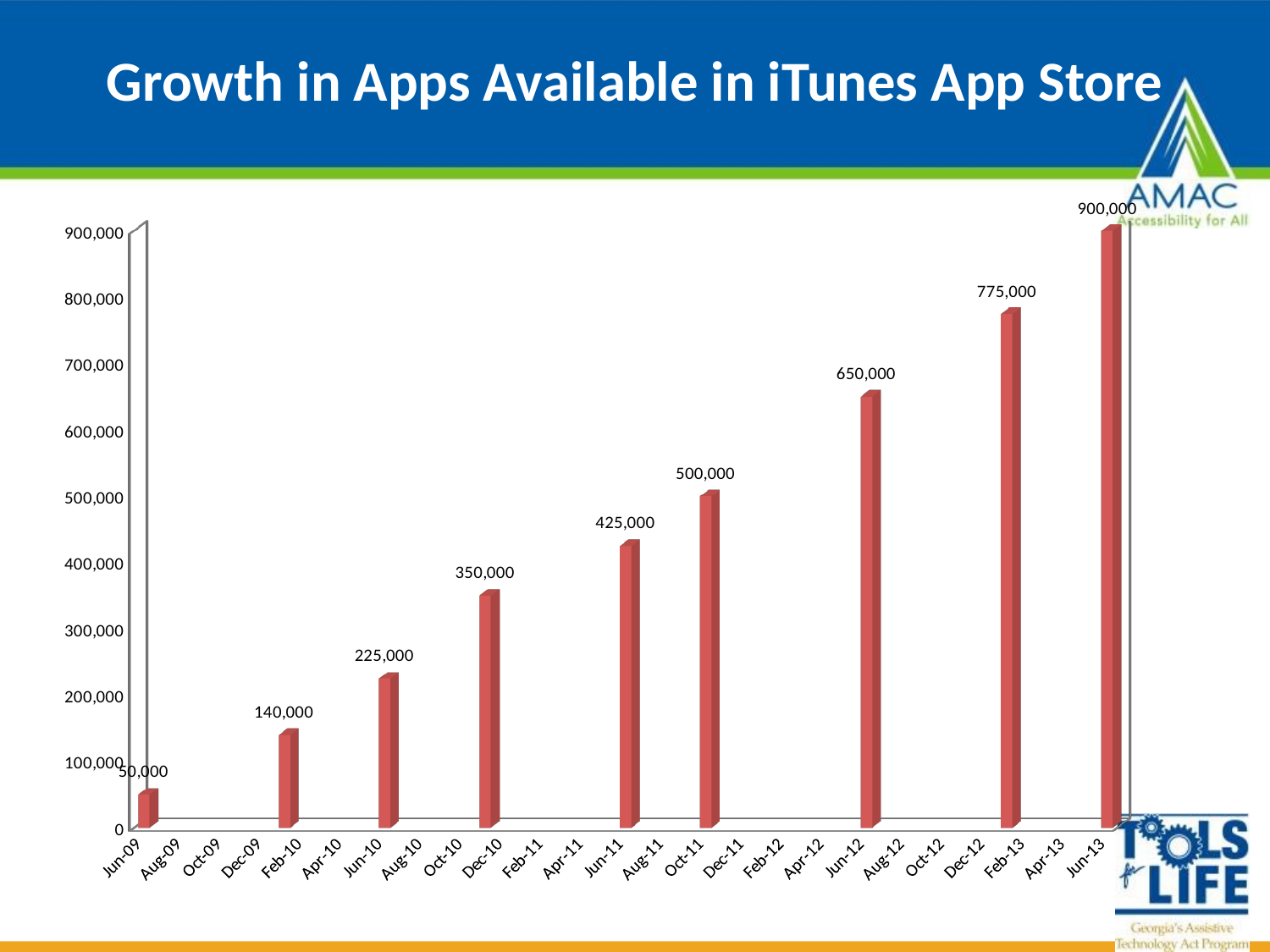
Which date has the lowest number of apps available? Jun-09 What kind of chart is shown on the slide? Bar chart What is the title of the chart? Growth in Apps Available in iTunes App Store Which date has the highest number of apps available? Jun-13 How many bars are plotted on the chart? 9 Which is larger, the value for Oct-11 or the value for Jun-10? Oct-11 What is the number of apps available in Jun-09? 50,000 What is the number of apps available in Jun-13? 900,000 Do the values rise or fall from Jun-09 to Jun-13? Rise What is the difference between the values for Jun-12 and Jun-11? 225,000